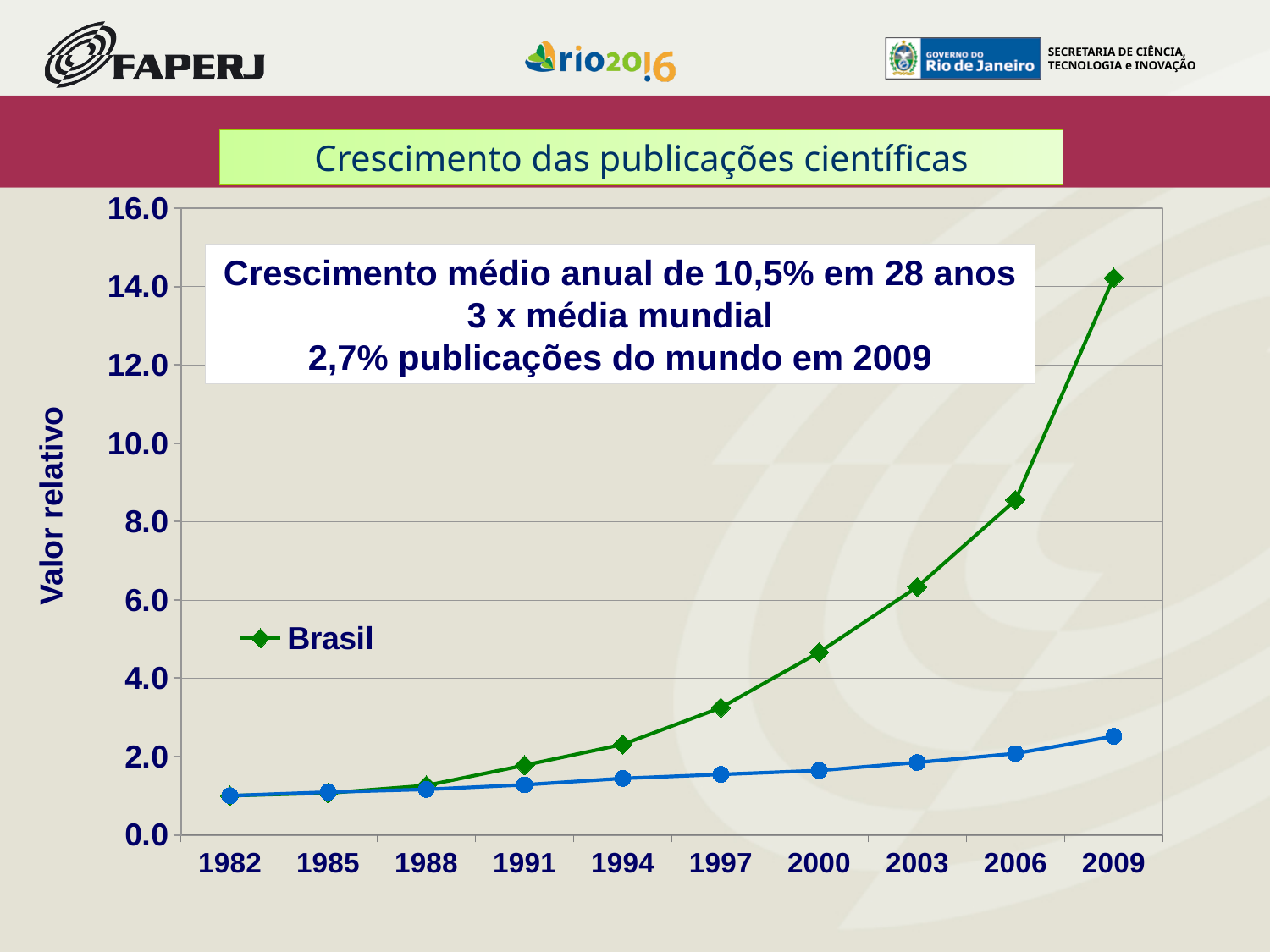
Which is larger in 2009, the Brasil series or the blue series? Brasil How many series does the legend list? 1 What kind of chart is shown on the slide? line chart Is the value for Brasil in 2009 greater or less than 12.0? greater How many years are shown along the x axis? 10 What is the title of the chart? Crescimento das publicações científicas In which year does the Brasil series have its lowest value? 1982 Is the value for Brasil in 2003 greater or less than 8.0? less What is the label of the vertical axis? Valor relativo Is the value for Brasil in 2006 greater or less than 8.0? greater In which year does the Brasil series reach its highest value? 2009 Does the Brasil series rise or fall from 1982 to 2009? rise